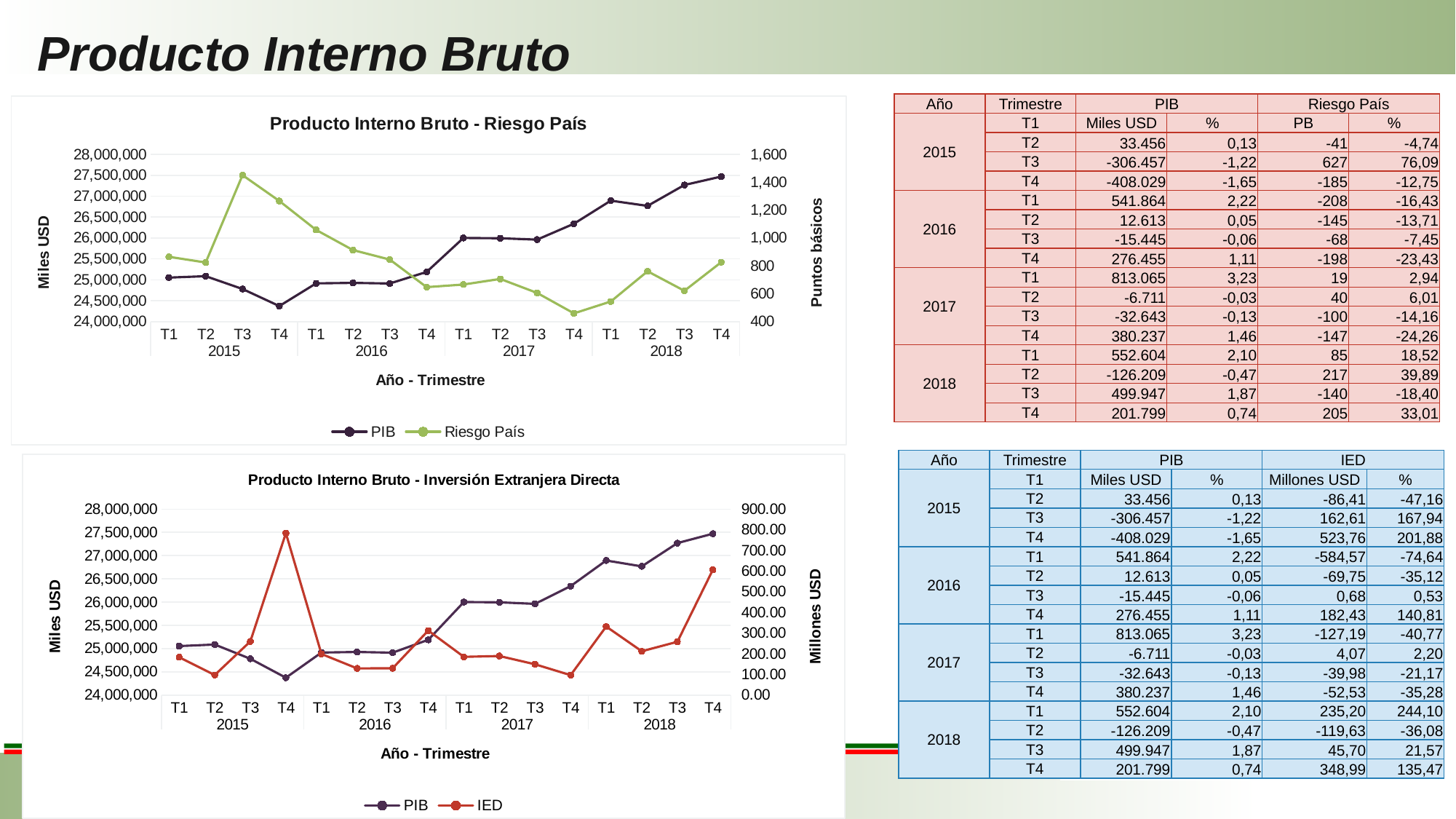
In the 'Producto Interno Bruto - Inversión Extranjera Directa' chart, in which quarter is IED highest? T4 2015 In the 'Producto Interno Bruto - Riesgo País' chart, in which quarter is Riesgo País lowest? T4 2017 In the 'Producto Interno Bruto - Inversión Extranjera Directa' chart, is the IED value for T4 2015 greater or less than 700.00? greater What is the label of the right-hand vertical axis in the 'Producto Interno Bruto - Riesgo País' chart? Puntos básicos In the 'Producto Interno Bruto - Riesgo País' chart, does PIB generally rise or fall from T1 2015 to T4 2018? rise In the 'Producto Interno Bruto - Riesgo País' chart, is the PIB value for T4 2018 greater or less than 27,000,000? greater How many series does the legend of the 'Producto Interno Bruto - Riesgo País' chart list? 2 How many quarters are plotted along the x axis of the 'Producto Interno Bruto - Inversión Extranjera Directa' chart? 16 In the 'Producto Interno Bruto - Riesgo País' chart, in which quarter is PIB highest? T4 2018 What kind of chart is the 'Producto Interno Bruto - Riesgo País' chart? line chart In the 'Producto Interno Bruto - Riesgo País' chart, in which quarter is Riesgo País highest? T3 2015 In the 'Producto Interno Bruto - Riesgo País' chart, in which quarter is PIB lowest? T4 2015